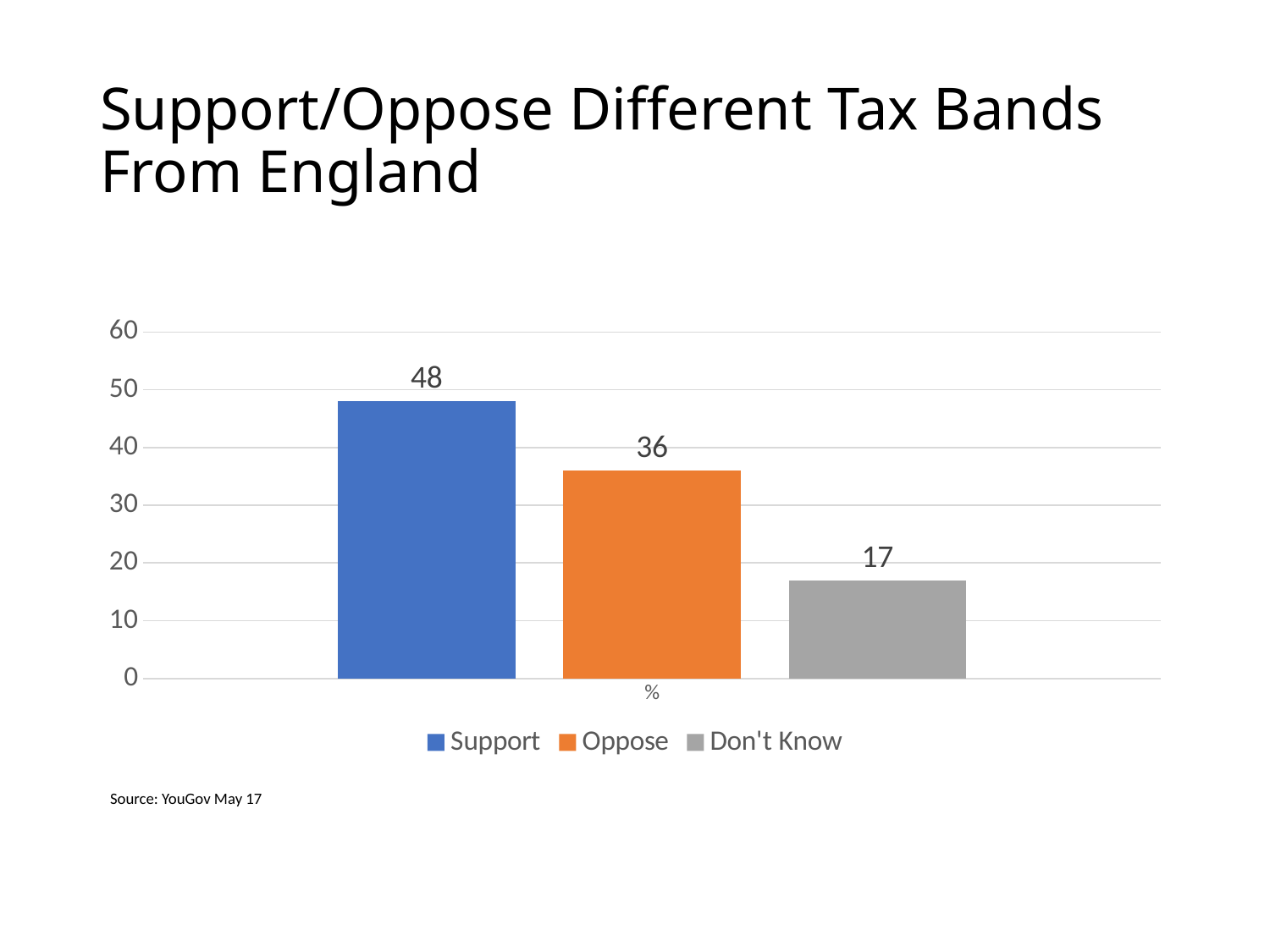
What is the value for Oppose? 36 What is the value for Don't Know? 17 Is the value for Don't Know greater or less than 20? less What is the value for Support? 48 What is the difference between the Support and Oppose values? 12 What colour is the Oppose bar? orange Which series has the lowest value? Don't Know Which series has the highest value? Support What kind of chart is shown on the slide? bar chart How many series does the legend list? 3 Which is larger, Support or Oppose? Support What is the difference between the Oppose and Don't Know values? 19